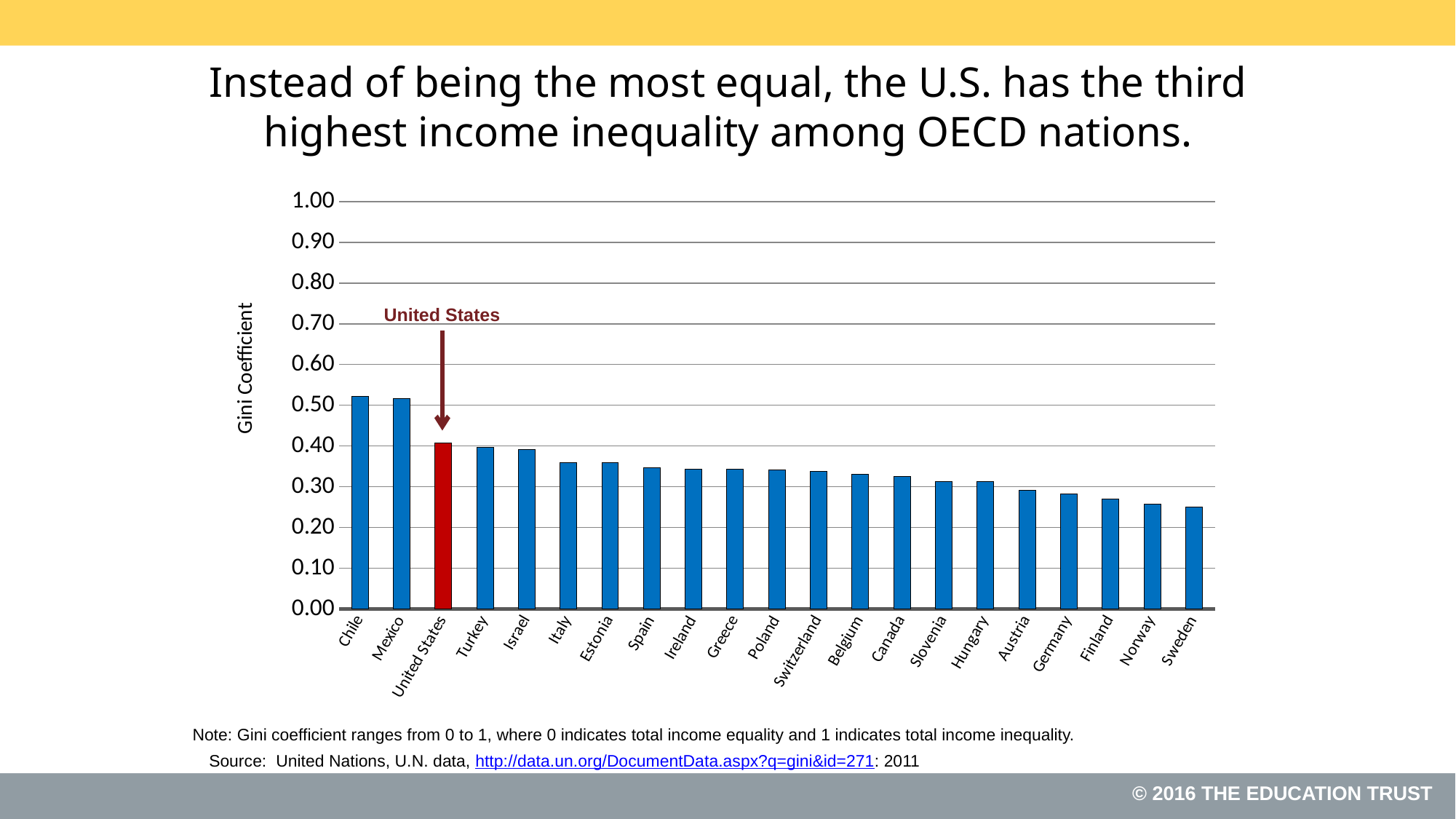
Is the Gini coefficient for the United States greater or less than 0.50? less Do the Gini coefficient values rise or fall moving from left to right along the x axis? Fall What is the label on the vertical axis of the chart? Gini Coefficient Is the Gini coefficient for Italy greater or less than 0.40? less Is the Gini coefficient for Sweden greater or less than 0.30? less Which country's bar is highlighted in red on the chart? United States How many countries are shown on the x axis of the chart? 21 Which has a higher Gini coefficient, Mexico or the United States? Mexico Which has a higher Gini coefficient, Italy or Germany? Italy What kind of chart is shown on the slide? Bar chart